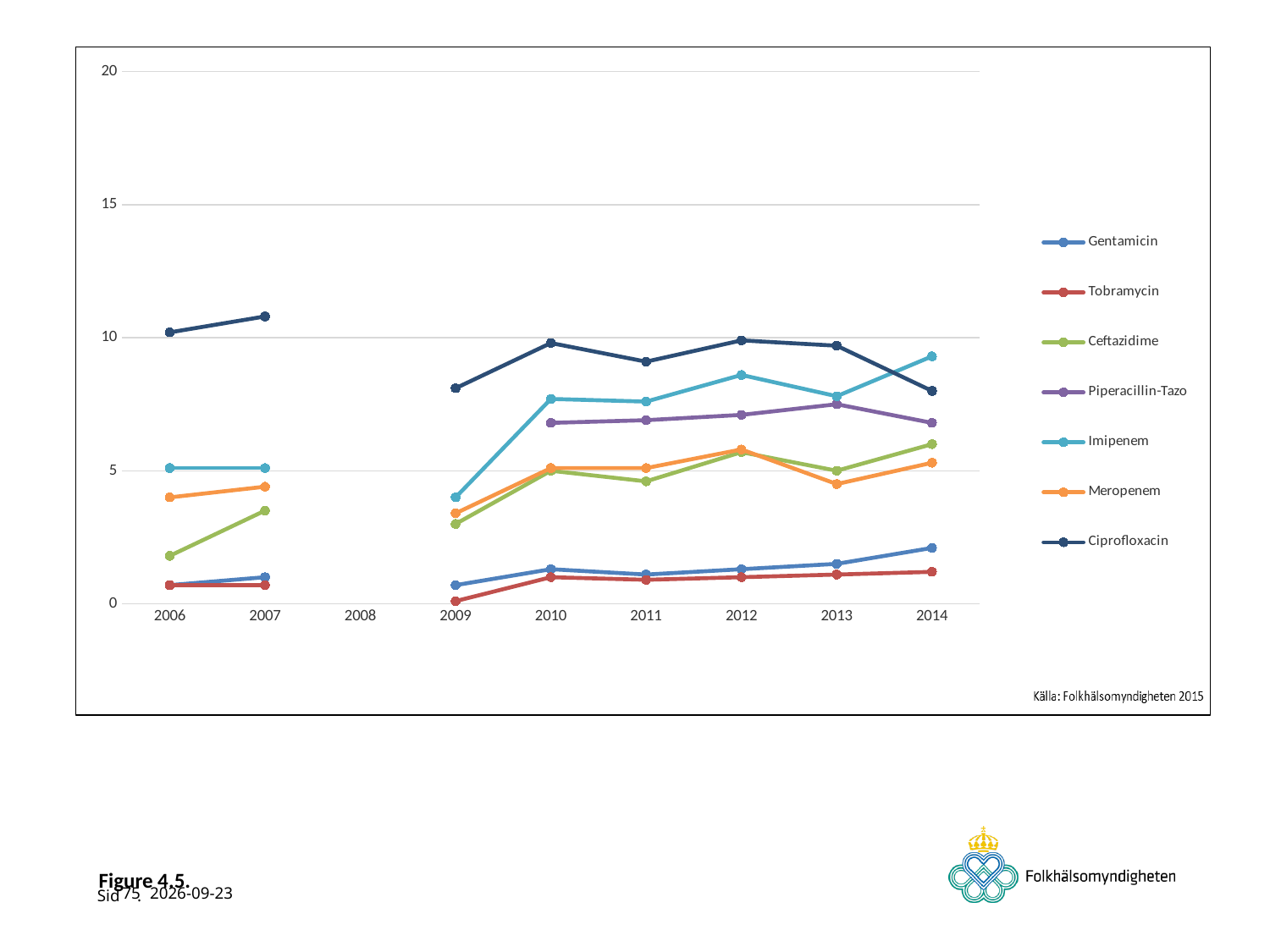
Is the value for Ceftazidime in 2009 greater or less than 5? less Is the value for Ciprofloxacin in 2007 greater or less than 10? greater How many year labels are shown on the x axis? 9 How many series does the legend list? 7 Is the value for Meropenem in 2012 greater or less than 5? greater Which series has the highest value in 2010? Ciprofloxacin Which series has the lowest value in 2009? Tobramycin What source is cited at the bottom right of the chart? Källa: Folkhälsomyndigheten 2015 In 2014, which is higher: Ciprofloxacin or Imipenem? Imipenem Does the Gentamicin line rise or fall from 2009 to 2014? rise What kind of chart is shown on the slide? line chart